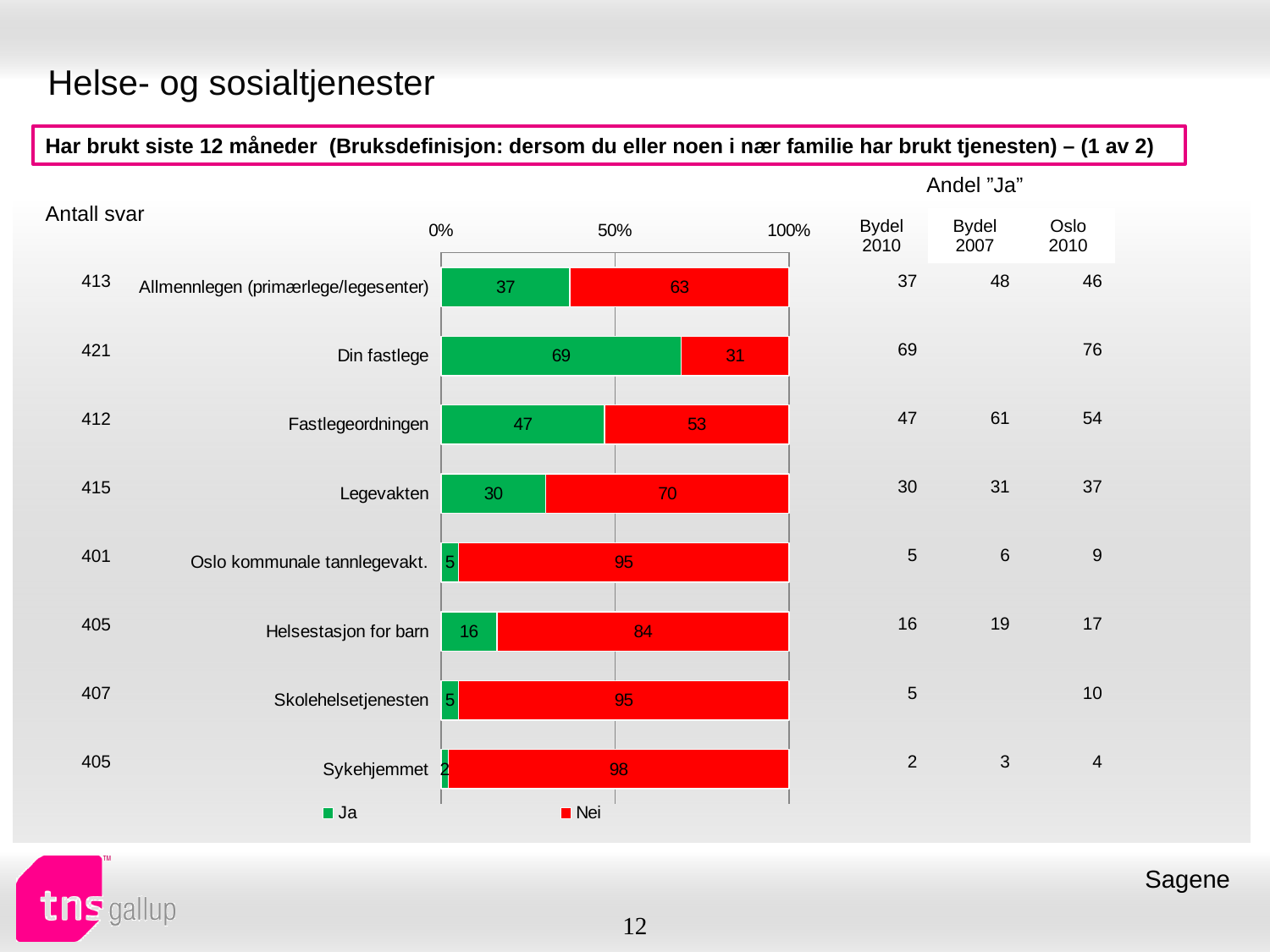
What is the difference between the "Nei" values for Sykehjemmet and Allmennlegen (primærlege/legesenter)? 35 What is the "Ja" value for Helsestasjon for barn? 16 Which category has the highest "Ja" value? Din fastlege What kind of chart is shown on the slide? stacked bar chart What is the total of the stacked bar for Oslo kommunale tannlegevakt.? 100 Which series is shown in red in the chart? Nei How many series does the chart legend list? 2 Which has a larger "Ja" value, Fastlegeordningen or Legevakten? Fastlegeordningen What is the "Ja" value for Din fastlege? 69 What is the "Nei" value for Legevakten? 70 Which category has the lowest "Ja" value? Sykehjemmet How many categories are plotted in the chart? 8